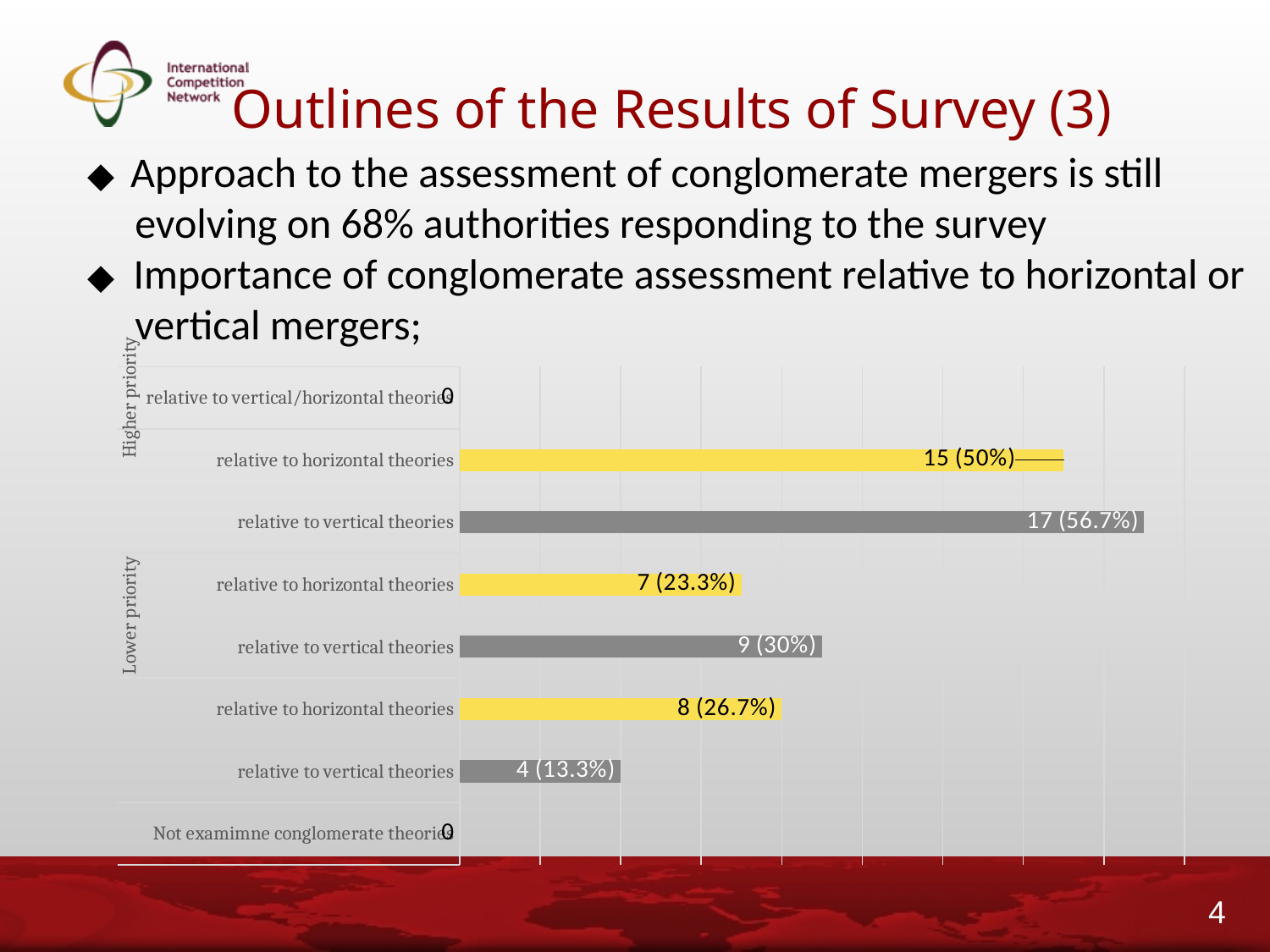
What is the value shown for 'Not examimne conglomerate theories'? 0 In the Lower priority group, what is the value for 'relative to vertical theories'? 9 (30%) What colour are the bars for 'relative to horizontal theories'? yellow What is the value of the bottom-most 'relative to vertical theories' bar (the one just above 'Not examimne conglomerate theories')? 4 (13.3%) Which category has the highest value in the chart? relative to vertical theories (17 (56.7%)) In the Lower priority group, which is larger: 'relative to horizontal theories' or 'relative to vertical theories'? relative to vertical theories What type of chart is shown on the slide? bar chart How many bars (categories) does the chart have? 8 In the Lower priority group, what is the value for 'relative to horizontal theories'? 7 (23.3%)